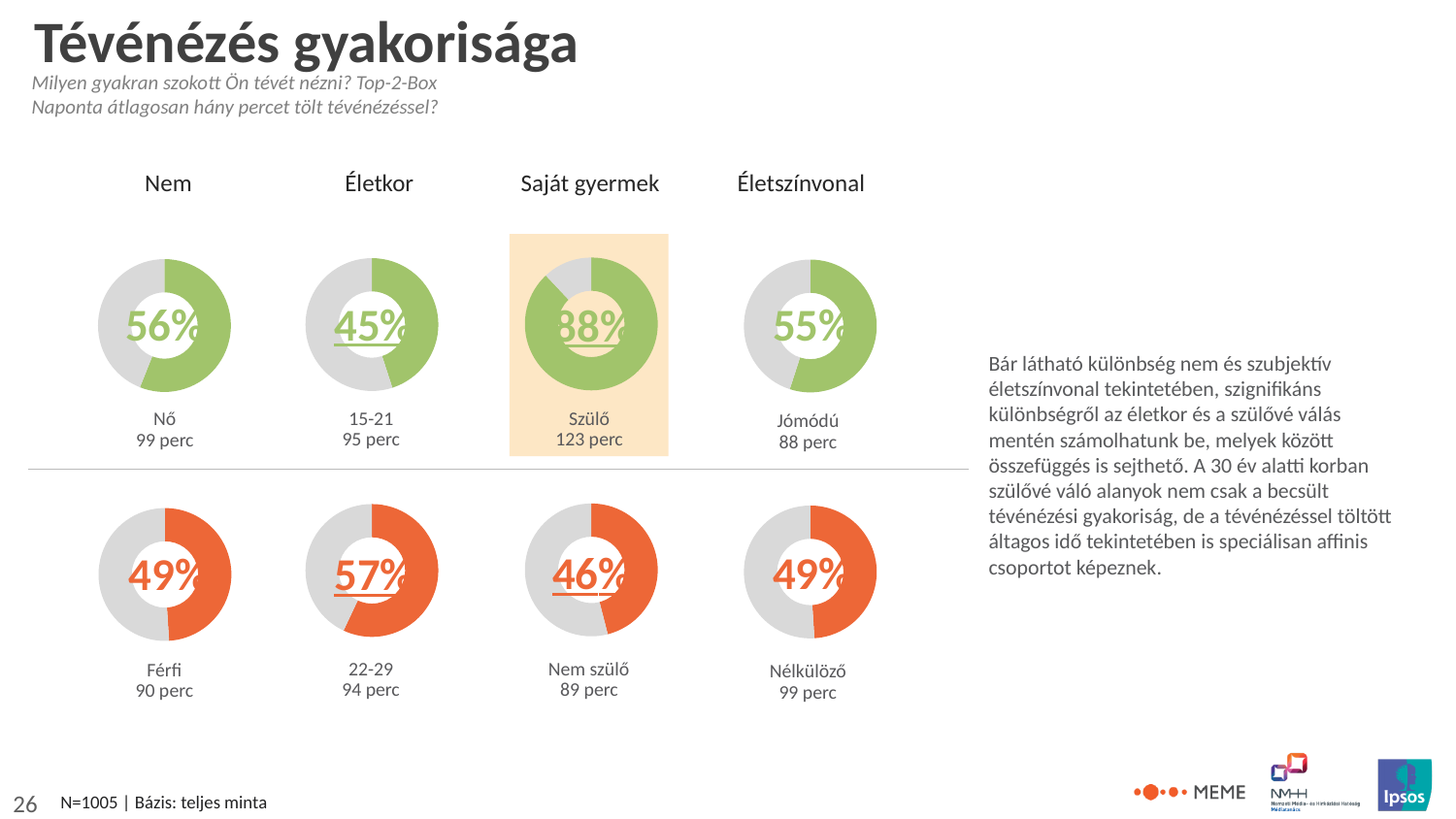
Which donut chart is highlighted with an orange background? Szülő What percentage is shown in the donut chart for Nő (women)? 56% Which of the eight donut charts shows the highest percentage? Szülő (88%) Which is larger, the percentage for Nő or the percentage for Férfi? Nő How many donut charts are on the slide? 8 How many minutes per day are shown under the Szülő donut chart? 123 perc What percentage is shown in the donut chart for Szülő (parents)? 88% What is the difference in percentage points between the Szülő and Nem szülő donut charts? 42 percentage points How many minutes per day are shown under the Jómódú donut chart? 88 perc Which of the eight donut charts shows the lowest percentage? 15-21 (45%) What kind of chart is used to show the percentages on this slide? Donut (pie) chart What percentage is shown in the donut chart for the 22-29 age group? 57%